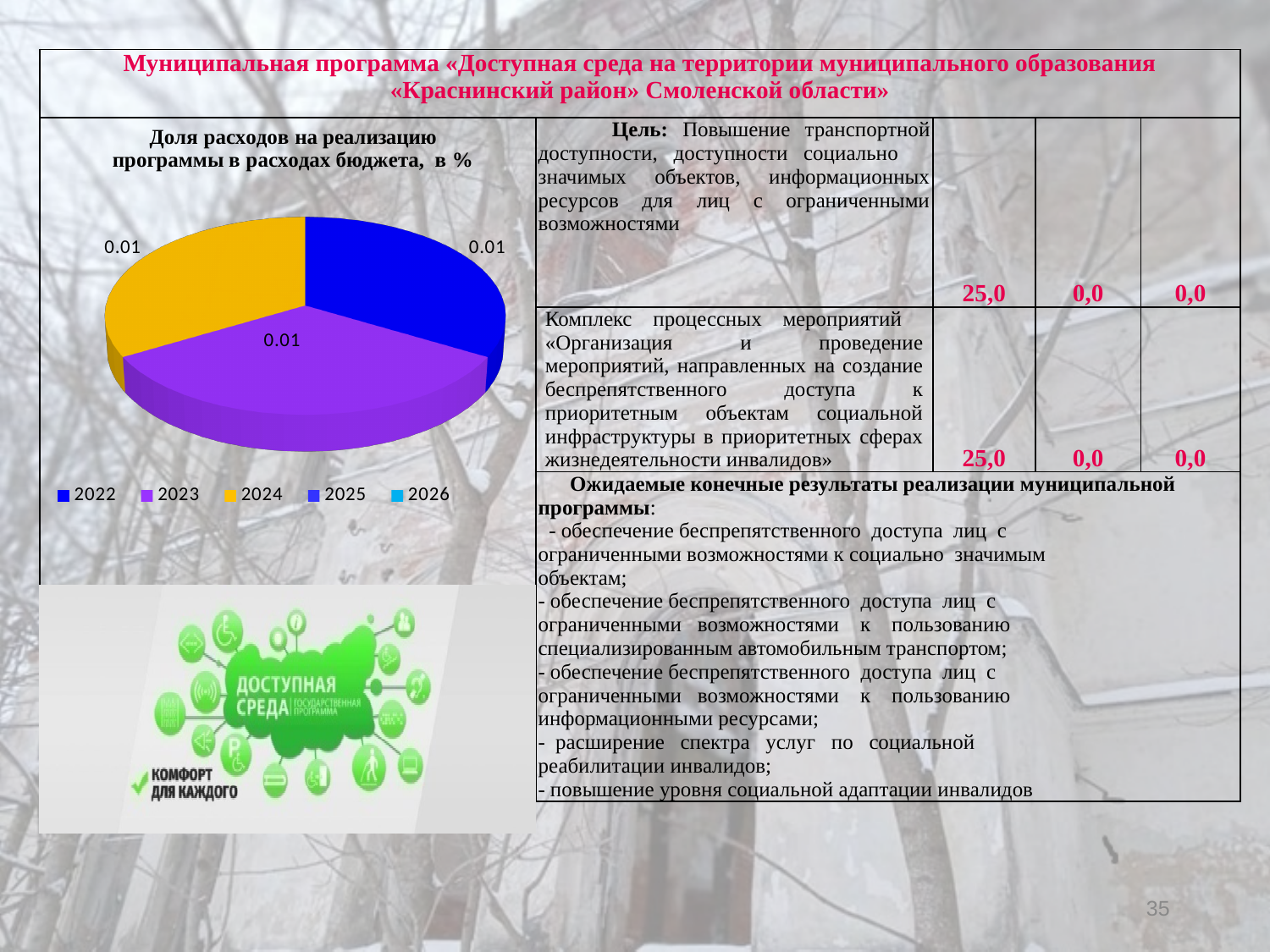
How many slices with data labels are visible in the pie chart? 3 What is the difference between the labelled values for 2022 and 2024 in the pie chart? 0 How many entries does the legend of the pie chart list? 5 What kind of chart is shown on the slide? pie chart What is the title of the pie chart? Доля расходов на реализацию программы в расходах бюджета, в % Which years listed in the legend are the first and last? 2022 and 2026 Which year does the purple slice of the pie chart represent? 2023 What value is labelled on the pie slice for 2023? 0.01 What value is labelled on the pie slice for 2024? 0.01 What value is labelled on the pie slice for 2022? 0.01